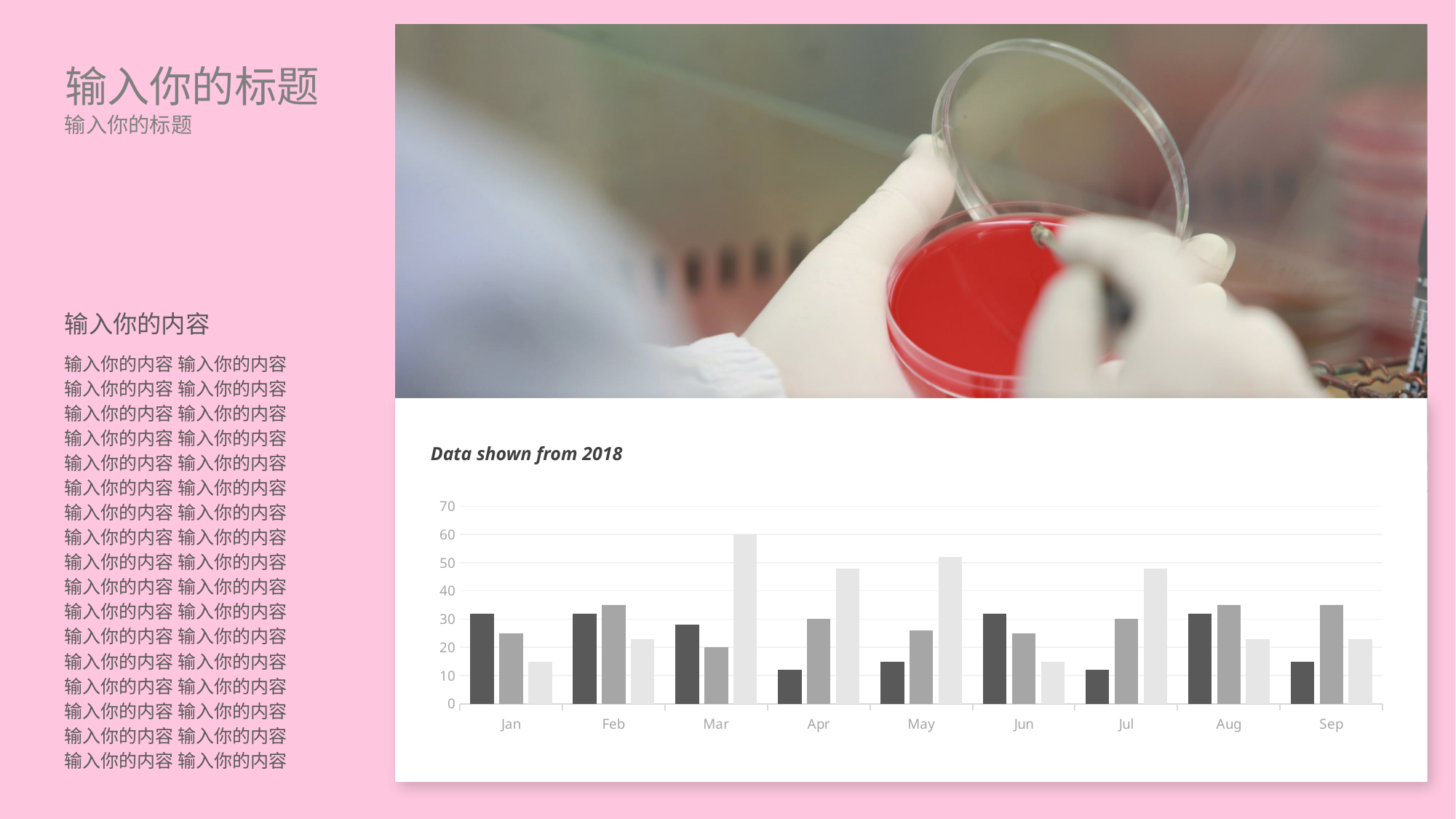
In May, which is taller: the darkest bar or the lightest bar? the lightest bar What is the title of the chart? Data shown from 2018 What value does the lightest bar for Mar reach on the axis? 60 How many bars are plotted for each month? 3 What kind of chart is shown on the slide? bar chart In Feb, which is taller: the darkest bar or the lightest bar? the darkest bar Which month has the tallest bar in the chart? Mar Is the lightest bar for Jan greater or less than 20? less Is the medium-gray bar for Sep greater or less than 30? greater Is the lightest bar for Mar greater or less than 50? greater How many months are shown on the x axis of the chart? 9